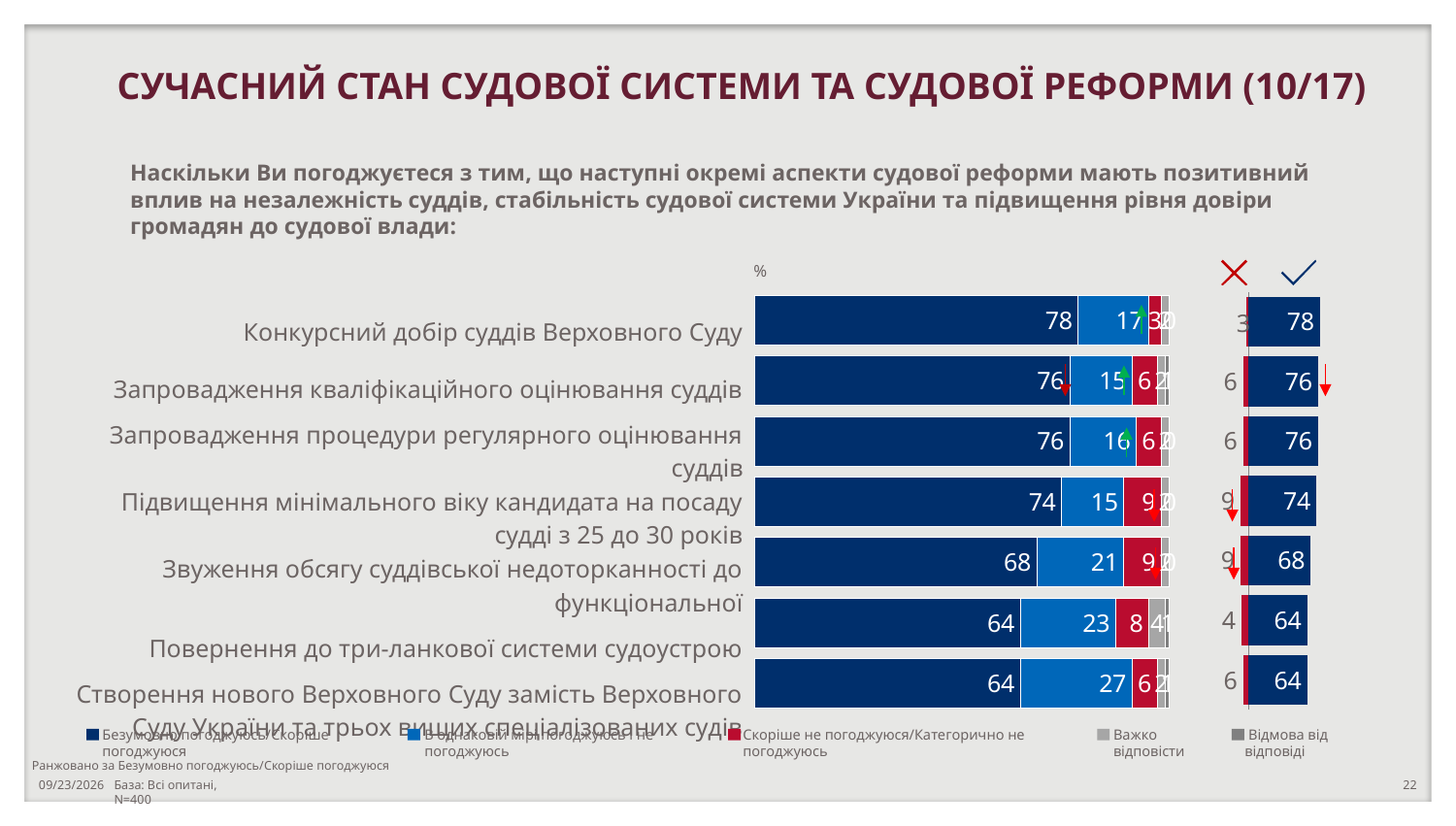
How many categories (aspects of judicial reform) are shown in the chart? 7 Which category has the highest value for "В однаковій мірі погоджуюся і не погоджуюсь"? Створення нового Верховного Суду замість Верховного Суду України та трьох вищих спеціалізованих судів What is the value of "Скоріше не погоджуюся/Категорично не погоджуюсь" for "Повернення до три-ланкової системи судоустрою"? 8 What is the value of "Безумовно погоджуюсь/Скоріше погоджуюся" for "Конкурсний добір суддів Верховного Суду"? 78 What is the value of "Скоріше не погоджуюся/Категорично не погоджуюсь" for "Підвищення мінімального віку кандидата на посаду судді з 25 до 30 років"? 9 Which colour represents "Безумовно погоджуюсь/Скоріше погоджуюся" in the chart? Dark blue What kind of chart is shown on the slide? Stacked bar chart What is the difference between the "Безумовно погоджуюсь/Скоріше погоджуюся" values for "Конкурсний добір суддів Верховного Суду" and "Повернення до три-ланкової системи судоустрою"? 14 Which has a larger "Безумовно погоджуюсь/Скоріше погоджуюся" value: "Звуження обсягу суддівської недоторканності до функціональної" or "Повернення до три-ланкової системи судоустрою"? Звуження обсягу суддівської недоторканності до функціональної How many series does the legend list? 5 Which category has the highest value for "Безумовно погоджуюсь/Скоріше погоджуюся"? Конкурсний добір суддів Верховного Суду What is the value of "В однаковій мірі погоджуюся і не погоджуюсь" for "Створення нового Верховного Суду замість Верховного Суду України та трьох вищих спеціалізованих судів"? 27